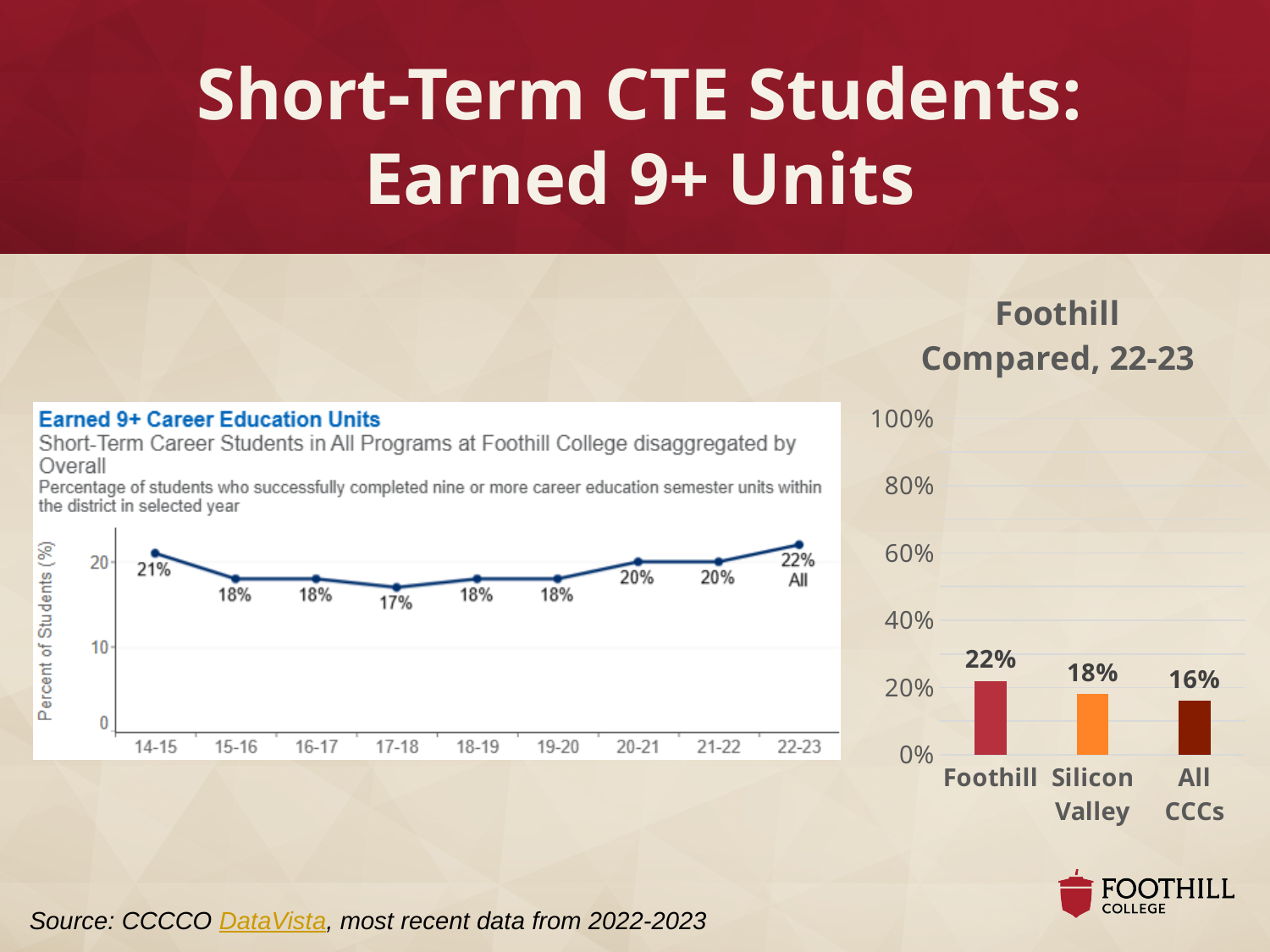
In the 'Foothill Compared, 22-23' chart, which category has the lowest value? All CCCs What kind of chart is the 'Foothill Compared, 22-23' chart on the right? Bar chart In the 'Earned 9+ Career Education Units' line chart, what is the value for 14-15? 21% In the 'Earned 9+ Career Education Units' line chart, which year has the lowest value? 17-18 In the 'Foothill Compared, 22-23' chart, is the value for Foothill greater or less than 40%? less In the 'Foothill Compared, 22-23' chart, what is the difference between Foothill and All CCCs? 6% In the 'Earned 9+ Career Education Units' line chart, how many years are plotted? 9 In the 'Earned 9+ Career Education Units' line chart, which year has the highest value? 22-23 In the 'Earned 9+ Career Education Units' line chart, what is the value for 17-18? 17% In the 'Foothill Compared, 22-23' chart, what is the value for Silicon Valley? 18% What kind of chart is the 'Earned 9+ Career Education Units' chart on the left? Line chart In the 'Earned 9+ Career Education Units' line chart, what is the difference between the 22-23 value and the 17-18 value? 5%